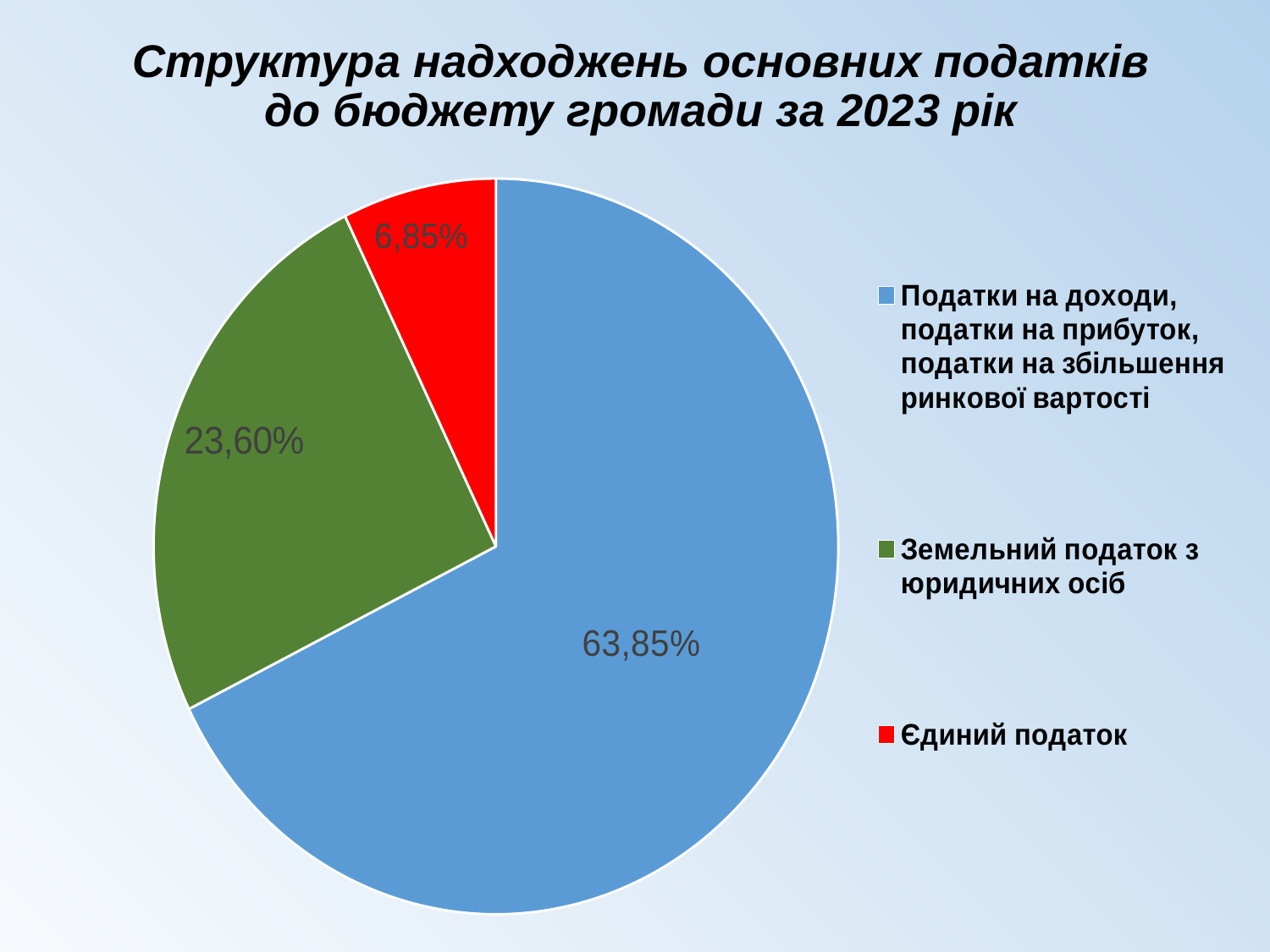
What is the difference between the shares of "Земельний податок з юридичних осіб" and "Єдиний податок"? 16,75% Which is larger: the share of "Земельний податок з юридичних осіб" or the share of "Єдиний податок"? Земельний податок з юридичних осіб What is the title of the chart? Структура надходжень основних податків до бюджету громади за 2023 рік What share of the pie does "Земельний податок з юридичних осіб" have? 23,60% What colour is the slice for "Єдиний податок"? red How many slices does the pie chart have? 3 What is the value shown for "Податки на доходи, податки на прибуток, податки на збільшення ринкової вартості"? 63,85% How many entries does the legend list? 3 Which category has the smallest slice of the pie? Єдиний податок Which category has the largest slice of the pie? Податки на доходи, податки на прибуток, податки на збільшення ринкової вартості What share of the pie does "Єдиний податок" have? 6,85% What kind of chart is shown on the slide? pie chart